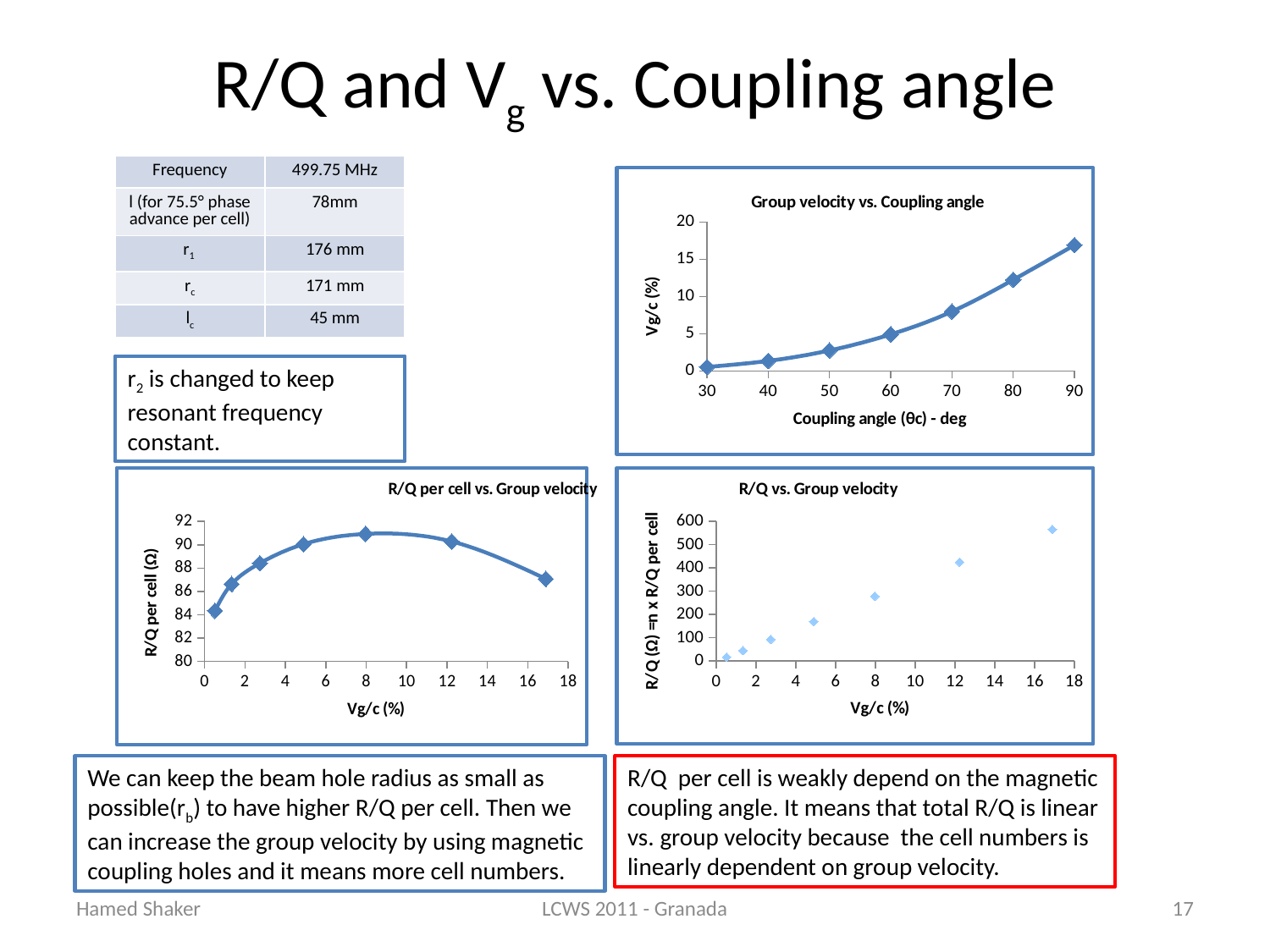
In the 'Group velocity vs. Coupling angle' chart, does Vg/c rise or fall as the coupling angle increases? rise In the 'R/Q per cell vs. Group velocity' chart, is the R/Q per cell value at the lowest group velocity (near Vg/c = 0) greater or less than 86? less In the 'Group velocity vs. Coupling angle' chart, is the value of Vg/c at a coupling angle of 30 degrees greater or less than 5? less In the 'R/Q vs. Group velocity' chart, what is the label of the y axis? R/Q (Ω) =n x R/Q per cell In the 'R/Q vs. Group velocity' chart, is the R/Q value at the highest group velocity (near Vg/c = 17) greater or less than 500? greater In the 'Group velocity vs. Coupling angle' chart, how many data points are plotted? 7 In the 'R/Q vs. Group velocity' chart, does R/Q rise or fall as Vg/c increases? rise In the 'Group velocity vs. Coupling angle' chart, what is the label of the x axis? Coupling angle (θc) - deg In the 'R/Q per cell vs. Group velocity' chart, how many data points are plotted? 7